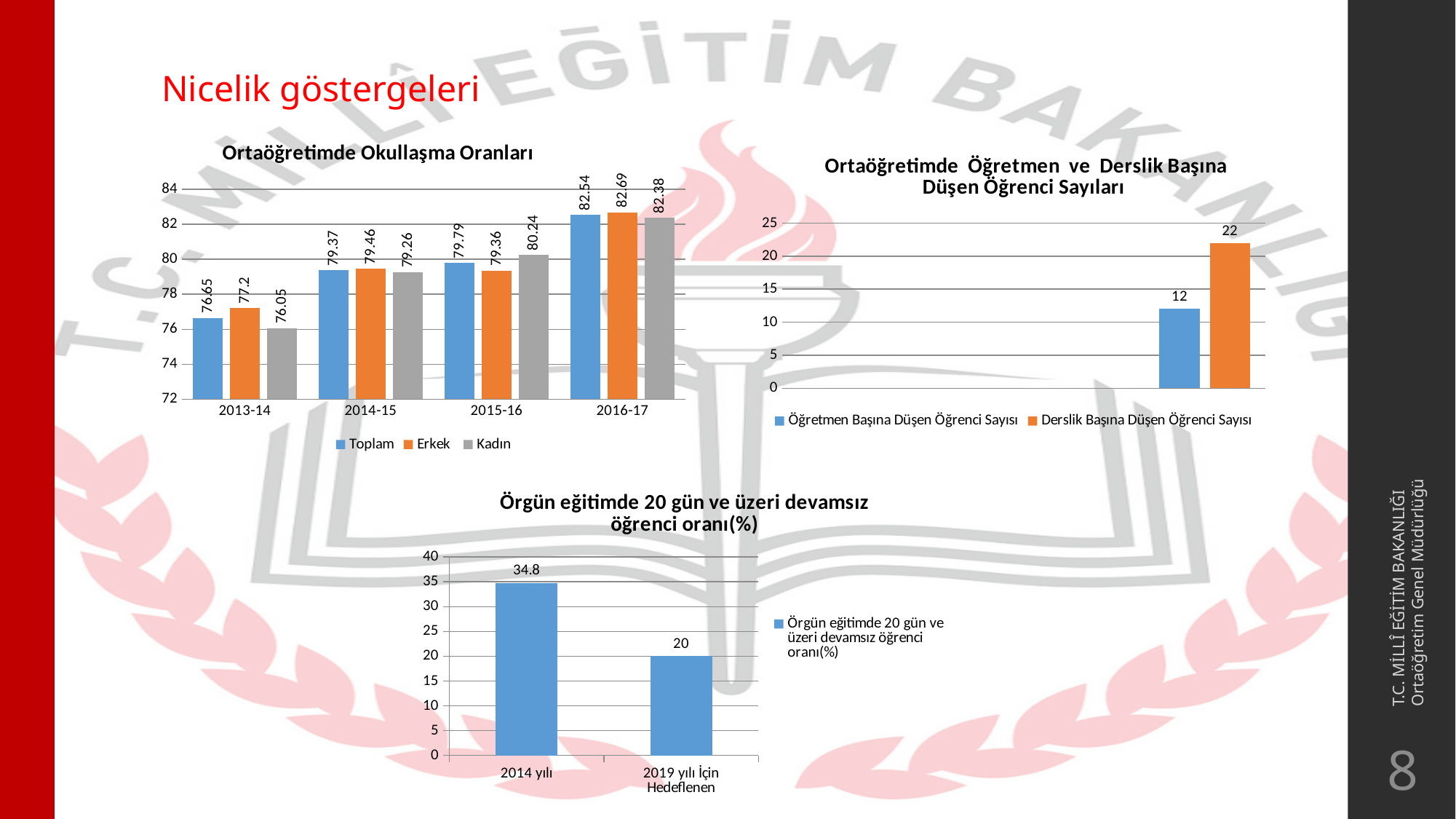
In the chart 'Ortaöğretimde Okullaşma Oranları', does the Toplam value rise or fall from 2013-14 to 2016-17? rise In the chart 'Örgün eğitimde 20 gün ve üzeri devamsız öğrenci oranı(%)', which is larger, the value for 2014 yılı or for 2019 yılı İçin Hedeflenen? 2014 yılı What kind of chart is 'Örgün eğitimde 20 gün ve üzeri devamsız öğrenci oranı(%)'? bar chart In the chart 'Ortaöğretimde Öğretmen ve Derslik Başına Düşen Öğrenci Sayıları', what is the difference between the Derslik and Öğretmen values? 10 In the chart 'Ortaöğretimde Okullaşma Oranları', what is the Kadın value for 2013-14? 76.05 In the chart 'Ortaöğretimde Okullaşma Oranları', what is the Toplam value for 2016-17? 82.54 In the chart 'Ortaöğretimde Okullaşma Oranları', how many series does the legend list? 3 In the chart 'Ortaöğretimde Öğretmen ve Derslik Başına Düşen Öğrenci Sayıları', what is the value for Derslik Başına Düşen Öğrenci Sayısı? 22 In the chart 'Ortaöğretimde Okullaşma Oranları', what is the difference between the Toplam values for 2016-17 and 2013-14? 5.89 In the chart 'Örgün eğitimde 20 gün ve üzeri devamsız öğrenci oranı(%)', what is the value for 2014 yılı? 34.8 In the chart 'Ortaöğretimde Okullaşma Oranları', which year has the lowest Kadın value? 2013-14 In the chart 'Ortaöğretimde Okullaşma Oranları', what is the Erkek value for 2015-16? 79.36